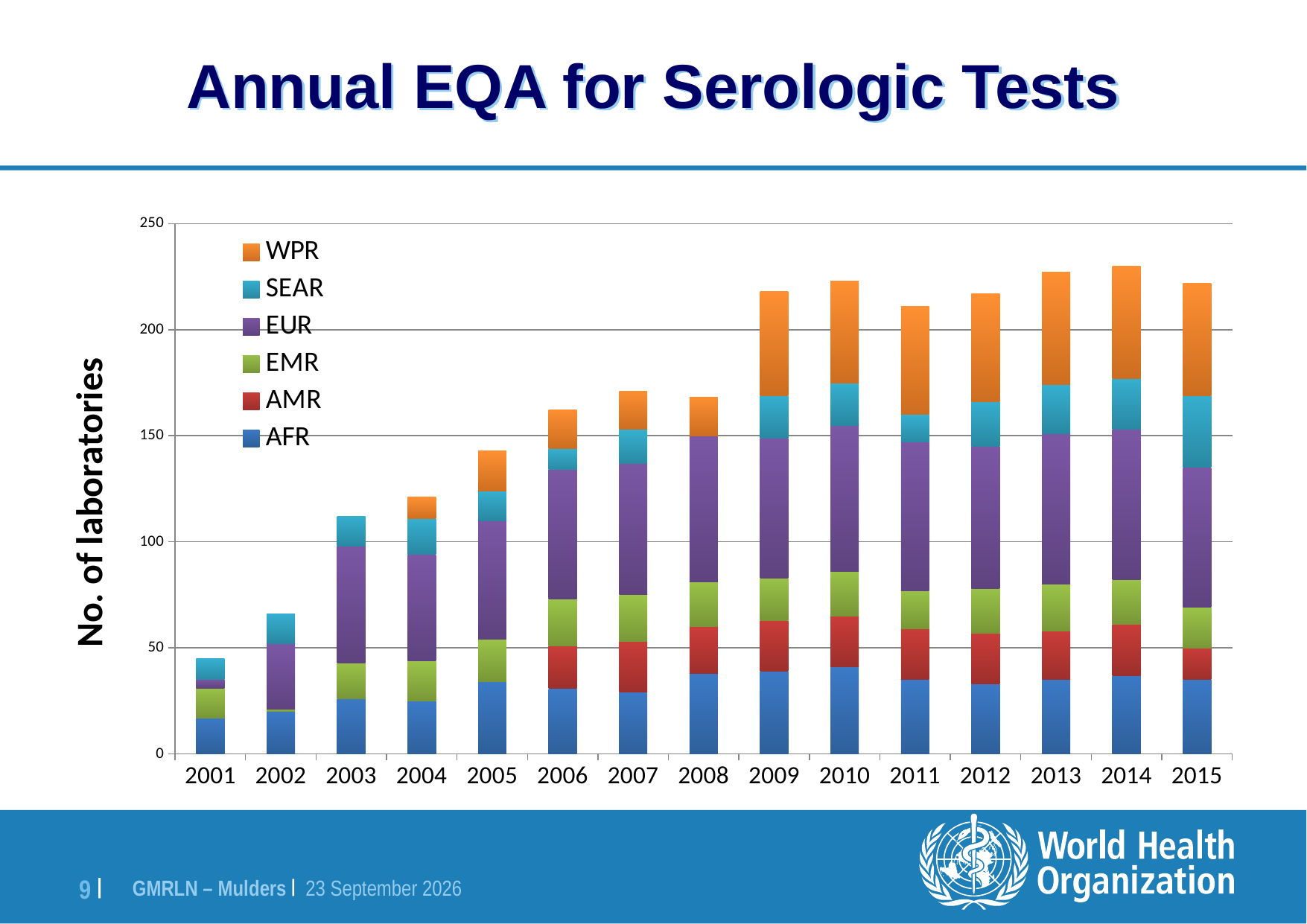
What is the title of the y axis? No. of laboratories Do the total numbers of laboratories generally rise or fall from 2001 to 2009? rise What kind of chart is shown on the slide? stacked bar chart Is the total number of laboratories in 2002 greater or less than 100? less Is the total number of laboratories in 2009 greater or less than 200? greater Is the total number of laboratories in 2006 greater or less than 150? greater Which year has the larger total number of laboratories, 2003 or 2002? 2003 How many years are shown along the x axis of the chart? 15 How many series does the legend list? 6 Which series is listed first (at the top) in the legend? WPR Which year has the lowest total number of laboratories? 2001